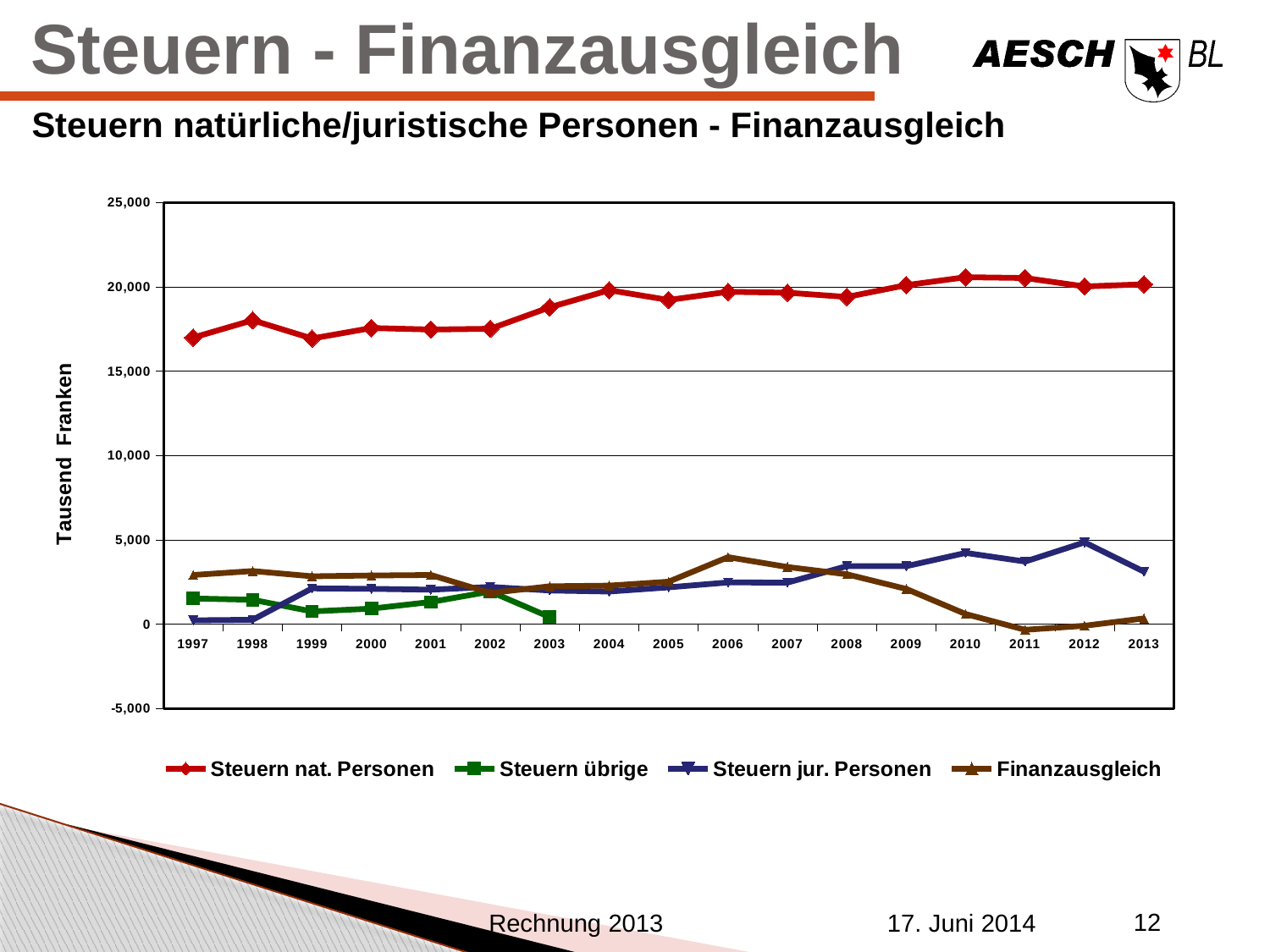
How many series does the legend list? 4 What kind of chart is shown on the slide? line chart Which series has the highest values across the whole chart? Steuern nat. Personen How many years are shown on the x axis? 17 What is the title of the vertical axis? Tausend Franken Is the value for Finanzausgleich in 2006 greater or less than 5,000? less Is the value for Steuern nat. Personen in 1997 greater or less than 15,000? greater In 1997, which is larger: Finanzausgleich or Steuern jur. Personen? Finanzausgleich Is the value for Steuern jur. Personen in 1997 greater or less than 5,000? less Does Finanzausgleich rise or fall from 2006 to 2011? fall In 2013, which is larger: Steuern jur. Personen or Finanzausgleich? Steuern jur. Personen In which year does Finanzausgleich reach its highest value? 2006